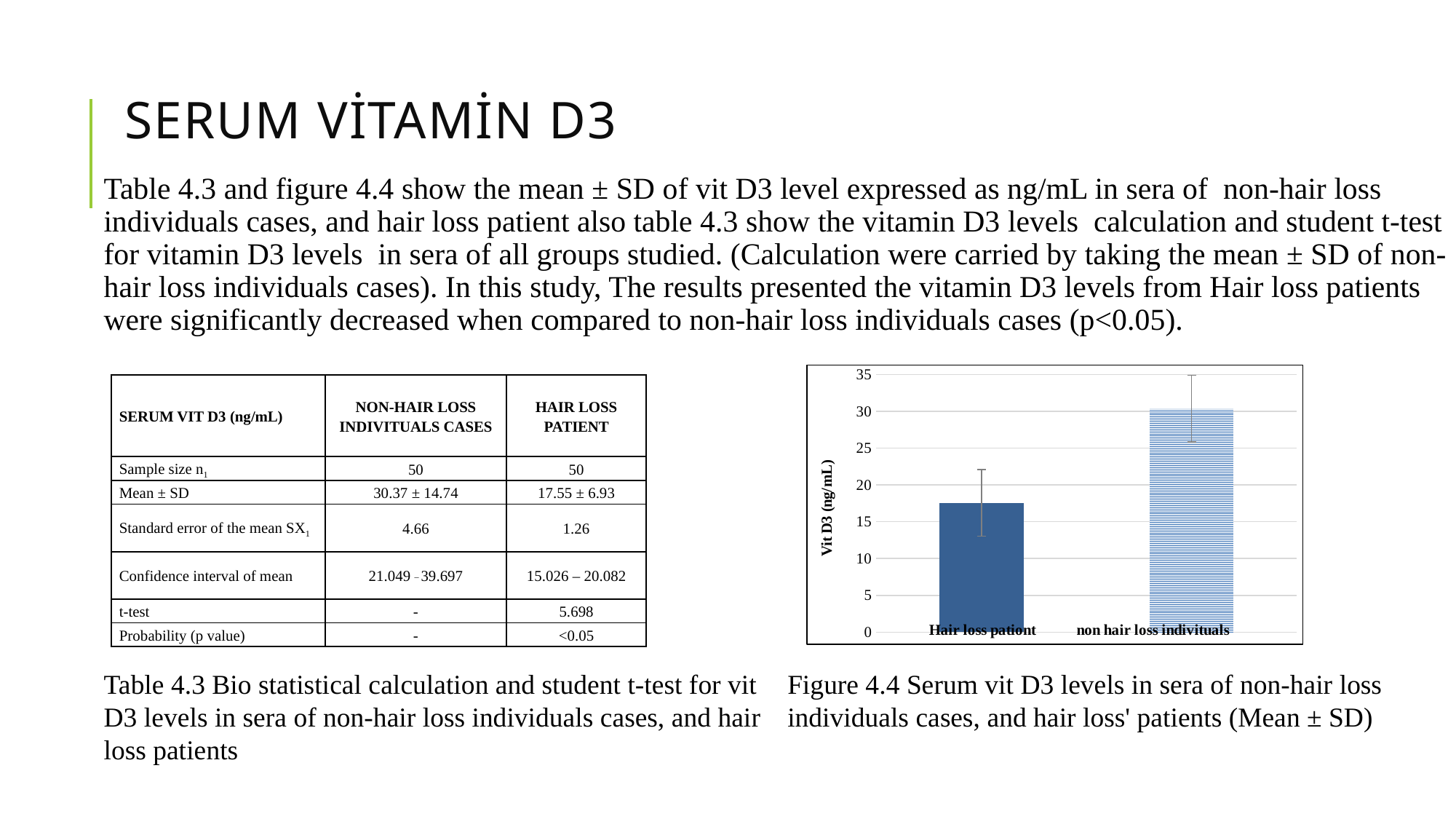
Is the bar for Hair loss patient greater or less than 15? greater How many bars are plotted in the chart? 2 Which category has the lowest bar in the chart? Hair loss patient What is the highest tick value shown on the vertical axis of the chart? 35 Is the bar for non hair loss individuals greater or less than 25? greater What is the label on the vertical axis of the chart? Vit D3 (ng/mL) Which bar is taller, Hair loss patient or non hair loss individuals? non hair loss individuals Is the bar for non hair loss individuals greater or less than 35? less Which category has the highest bar in the chart? non hair loss individuals What kind of chart is shown in Figure 4.4? bar chart